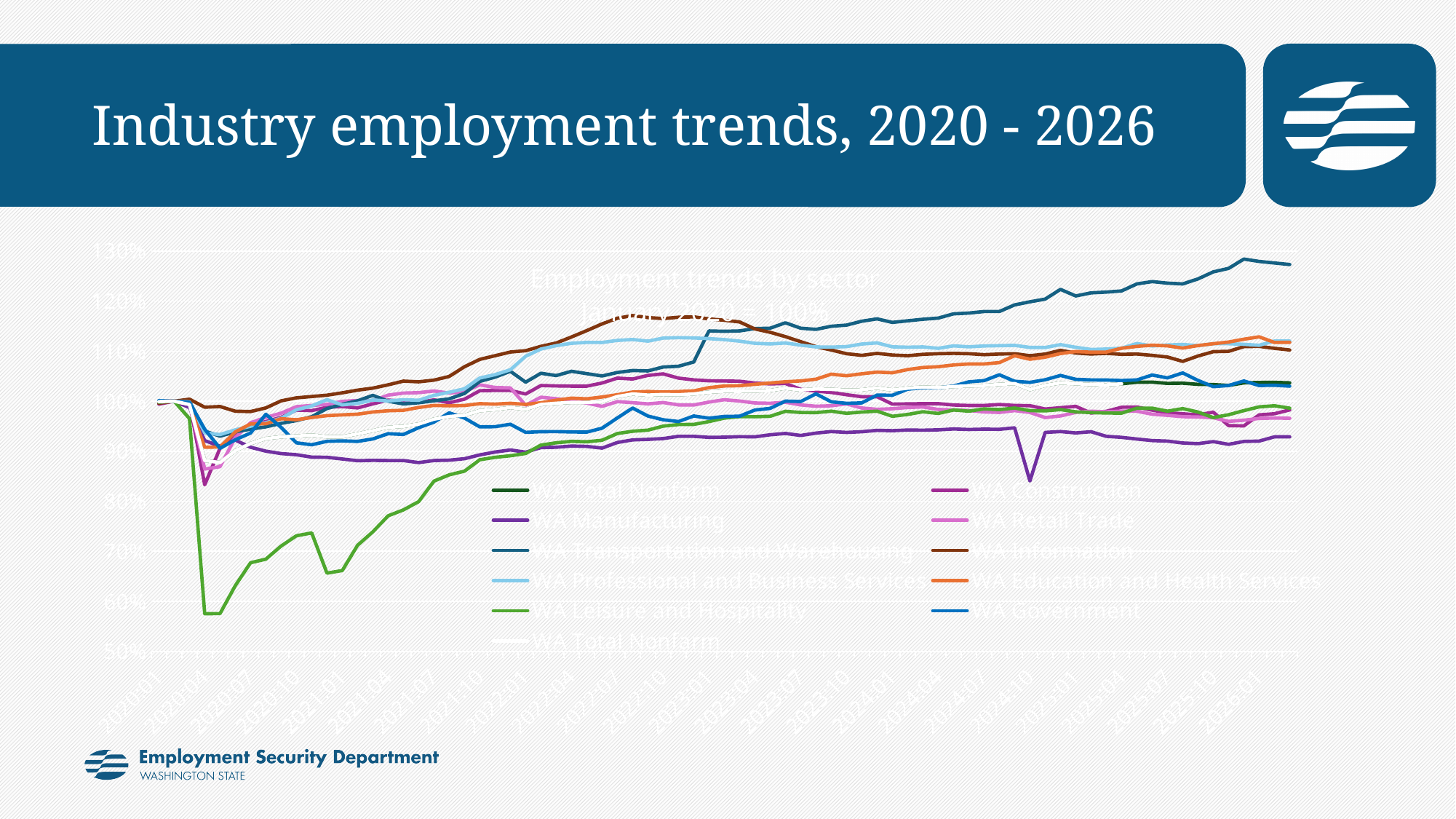
Is the lowest value for WA Leisure and Hospitality in 2020 greater or less than 60%? less Which series reaches the highest value at the right end of the chart (2026-01)? WA Transportation and Warehousing Does the WA Leisure and Hospitality line rise or fall from 2020-04 to 2022-01? rise Is the value for WA Transportation and Warehousing at 2026-01 greater or less than 120%? greater What is the title of the chart? Employment trends by sector, January 2020 = 100% At 2026-01, which is larger: WA Transportation and Warehousing or WA Manufacturing? WA Transportation and Warehousing What is the lowest value shown on the vertical axis? 50% Is the value for WA Manufacturing at 2026-01 greater or less than 100%? less Which series drops to the lowest value on the chart in 2020? WA Leisure and Hospitality How many entries does the chart legend list? 11 Does the WA Transportation and Warehousing line generally rise or fall from 2021 to 2026? rise What kind of chart is shown on the slide? line chart